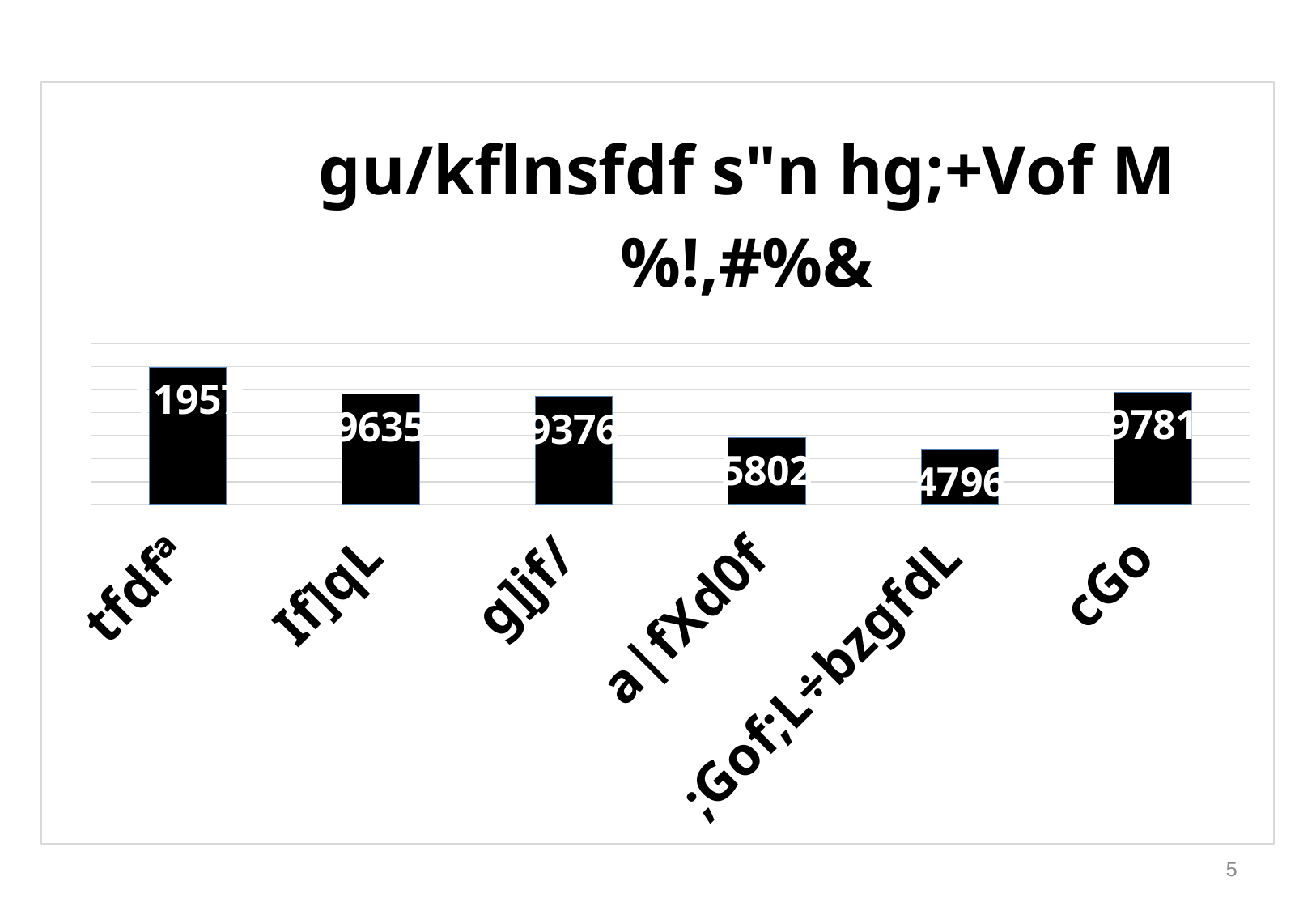
What is the value shown for the category ;Gof;L÷bzgfdL? 4796 What is the difference between the values for a|fXd0f and ;Gof;L÷bzgfdL? 1006 Which is larger, the value for cGo or the value for If]qL? cGo Which category has the lowest value? ;Gof;L÷bzgfdL What is the value shown for the category If]qL? 9635 What kind of chart is shown on the slide? bar chart What is the value shown for the category a|fXd0f? 5802 What is the value shown for the category cGo? 9781 What is the value shown for the category g]jf/? 9376 How many bars (categories) does the chart show? 6 What is the title of the chart? gu/kflnsfdf s"n hg;+Vof M %!,#%& Which category has the highest bar? tfdfª